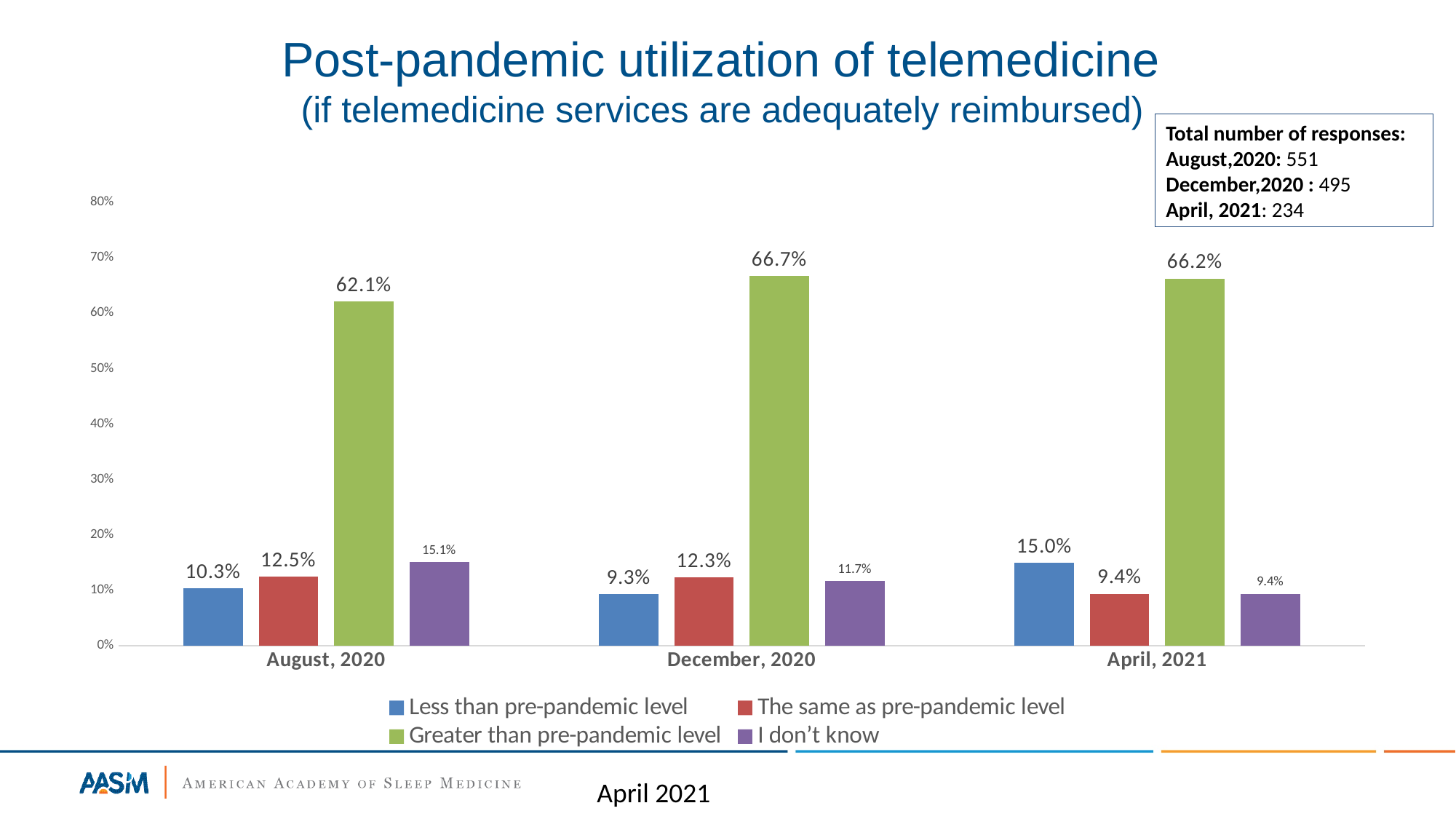
What is the value for 'I don't know' in August, 2020? 15.1% What percentage of respondents in December, 2020 expected telemedicine utilization greater than pre-pandemic level? 66.7% How many series does the legend list? 4 Is the value for 'Greater than pre-pandemic level' in April, 2021 greater or less than 60%? greater Which survey period has the lowest value for 'Less than pre-pandemic level'? December, 2020 Which is larger in April, 2021: 'Less than pre-pandemic level' or 'The same as pre-pandemic level'? Less than pre-pandemic level What is the difference between the 'Greater than pre-pandemic level' values for December, 2020 and August, 2020? 4.6% What is the value for 'Less than pre-pandemic level' in April, 2021? 15.0% How many survey periods are shown on the x axis? 3 Which colour represents 'The same as pre-pandemic level' in the chart? Red What kind of chart is shown on the slide? Bar chart Which survey period has the highest value for 'Greater than pre-pandemic level'? December, 2020